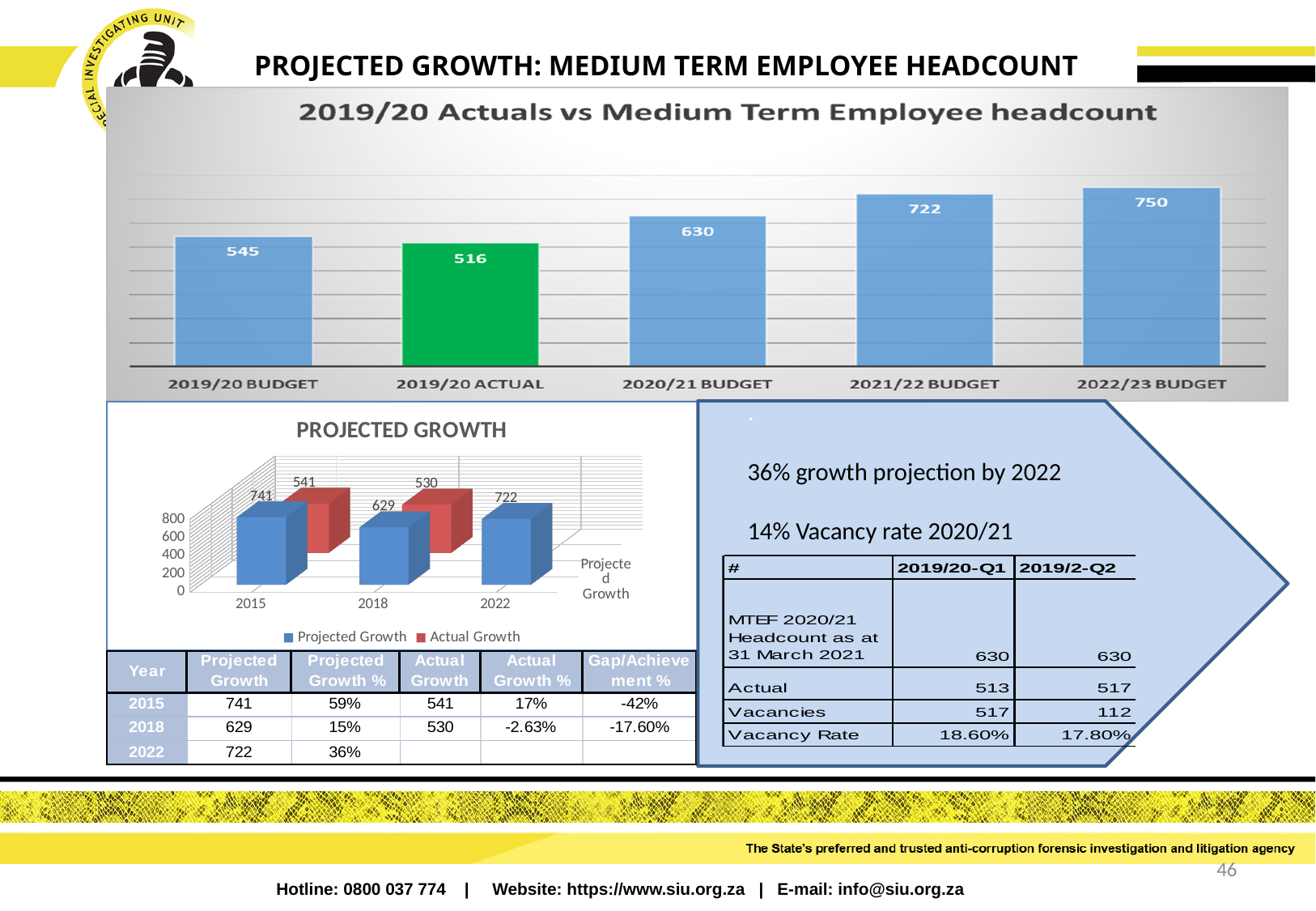
In the 'PROJECTED GROWTH' chart, what is the Actual Growth value for 2015? 541 In the '2019/20 Actuals vs Medium Term Employee headcount' chart, what is the difference between the 2019/20 BUDGET and 2019/20 ACTUAL values? 29 In the '2019/20 Actuals vs Medium Term Employee headcount' chart, how many bars are plotted? 5 In the '2019/20 Actuals vs Medium Term Employee headcount' chart, which category has the lowest value? 2019/20 ACTUAL In the 'PROJECTED GROWTH' chart, which is larger for 2015: Projected Growth or Actual Growth? Projected Growth In the '2019/20 Actuals vs Medium Term Employee headcount' chart, what is the value for 2019/20 ACTUAL? 516 In the '2019/20 Actuals vs Medium Term Employee headcount' chart, which category has the highest value? 2022/23 BUDGET In the 'PROJECTED GROWTH' chart, what is the Projected Growth value for 2018? 629 In the '2019/20 Actuals vs Medium Term Employee headcount' chart, which bar is coloured green? 2019/20 ACTUAL In the '2019/20 Actuals vs Medium Term Employee headcount' chart, what is the value for 2021/22 BUDGET? 722 In the 'PROJECTED GROWTH' chart, how many series does the legend list? 2 In the '2019/20 Actuals vs Medium Term Employee headcount' chart, do the budget values rise or fall from 2020/21 to 2022/23? rise